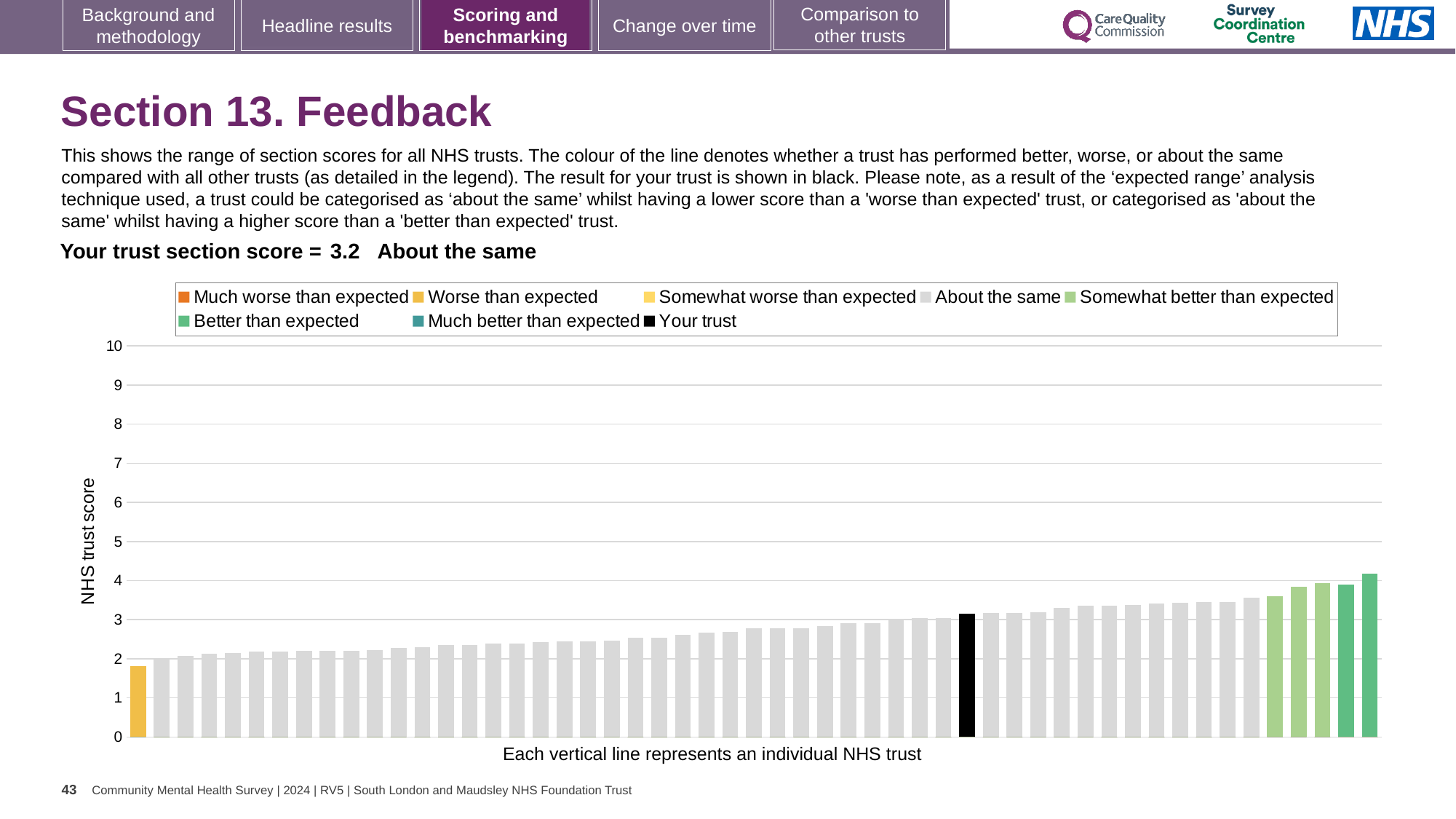
Is the value for the lowest-scoring trust (the leftmost bar) greater or less than 2? less What colour is the bar representing your trust? black Is your trust's bar higher or lower than the leftmost bar? higher Is your trust's bar higher or lower than the rightmost bar? lower Is the value for the highest-scoring trust (the rightmost bar) greater or less than 5? less What is the section score for your trust shown on the slide? 3.2 Do the bar values rise or fall from left to right along the x axis? rise What kind of chart is shown on the slide? bar chart Which performance category is your trust placed in for Section 13? About the same How many entries does the chart legend list? 8 What is the label on the vertical axis of the chart? NHS trust score Is the value for your trust greater or less than 3? greater